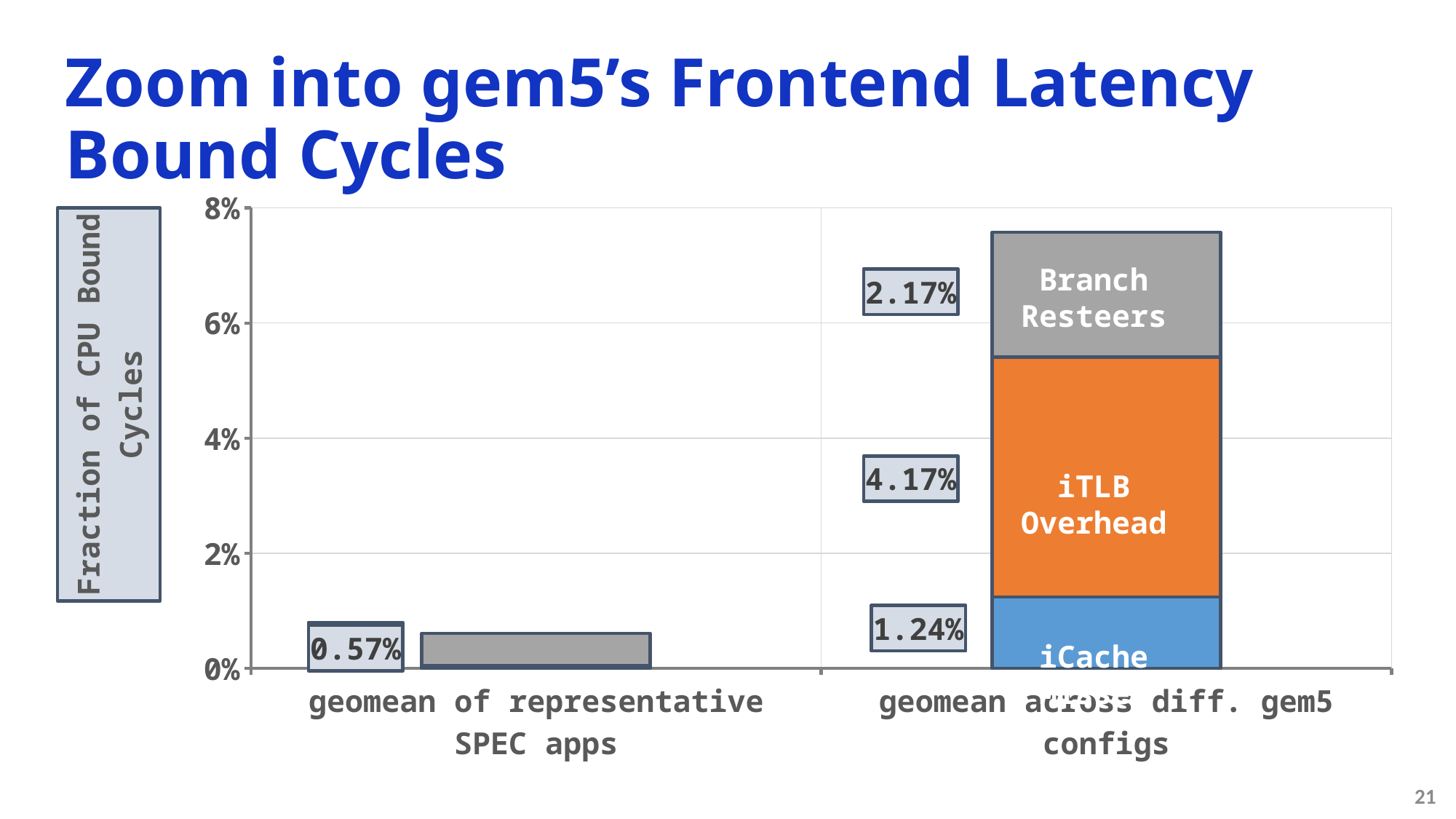
What is the difference between the iTLB Overhead segment and the Branch Resteers segment? 2.00% What is the value for 'geomean of representative SPEC apps'? 0.57% Which segment of the 'geomean across diff. gem5 configs' bar is the largest? iTLB Overhead How many categories are shown on the x axis? 2 Which segment of the 'geomean across diff. gem5 configs' bar is the smallest? iCache What is the value of the iTLB Overhead segment in the 'geomean across diff. gem5 configs' bar? 4.17% Is the total for 'geomean across diff. gem5 configs' greater or less than 6%? greater Which bar is taller: 'geomean of representative SPEC apps' or 'geomean across diff. gem5 configs'? geomean across diff. gem5 configs What is the value of the Branch Resteers segment in the 'geomean across diff. gem5 configs' bar? 2.17% What is the total of the stacked 'geomean across diff. gem5 configs' bar? 7.58% What kind of chart is shown on the slide? Stacked bar chart What is the value of the iCache segment in the 'geomean across diff. gem5 configs' bar? 1.24%